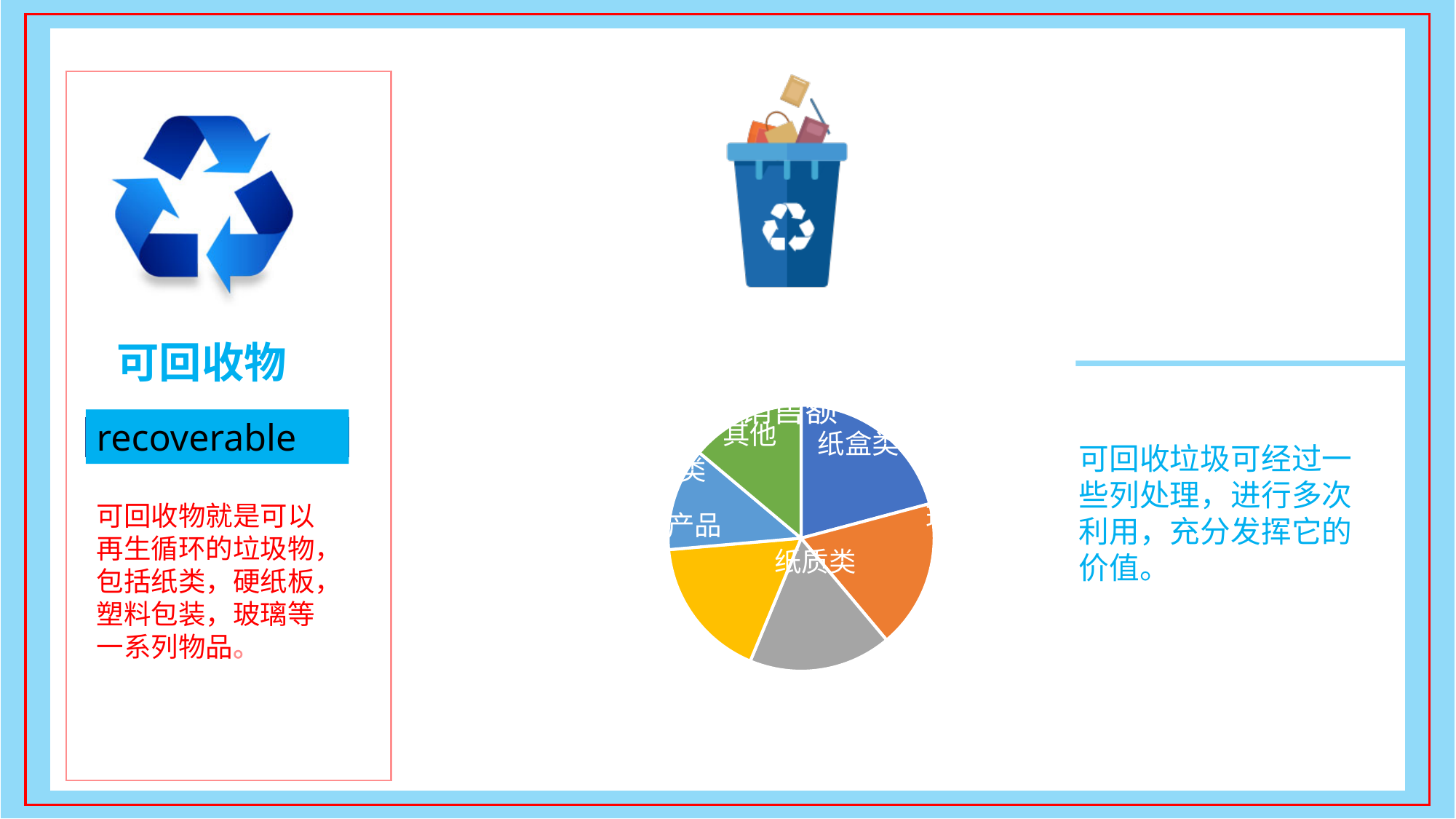
What kind of chart is shown on the slide? pie chart What colour is the 纸盒类 slice in the pie chart? blue Which slice is larger in the pie chart, 纸盒类 or 其他? 纸盒类 How many slices does the pie chart have? 6 What colour is the 其他 slice in the pie chart? green